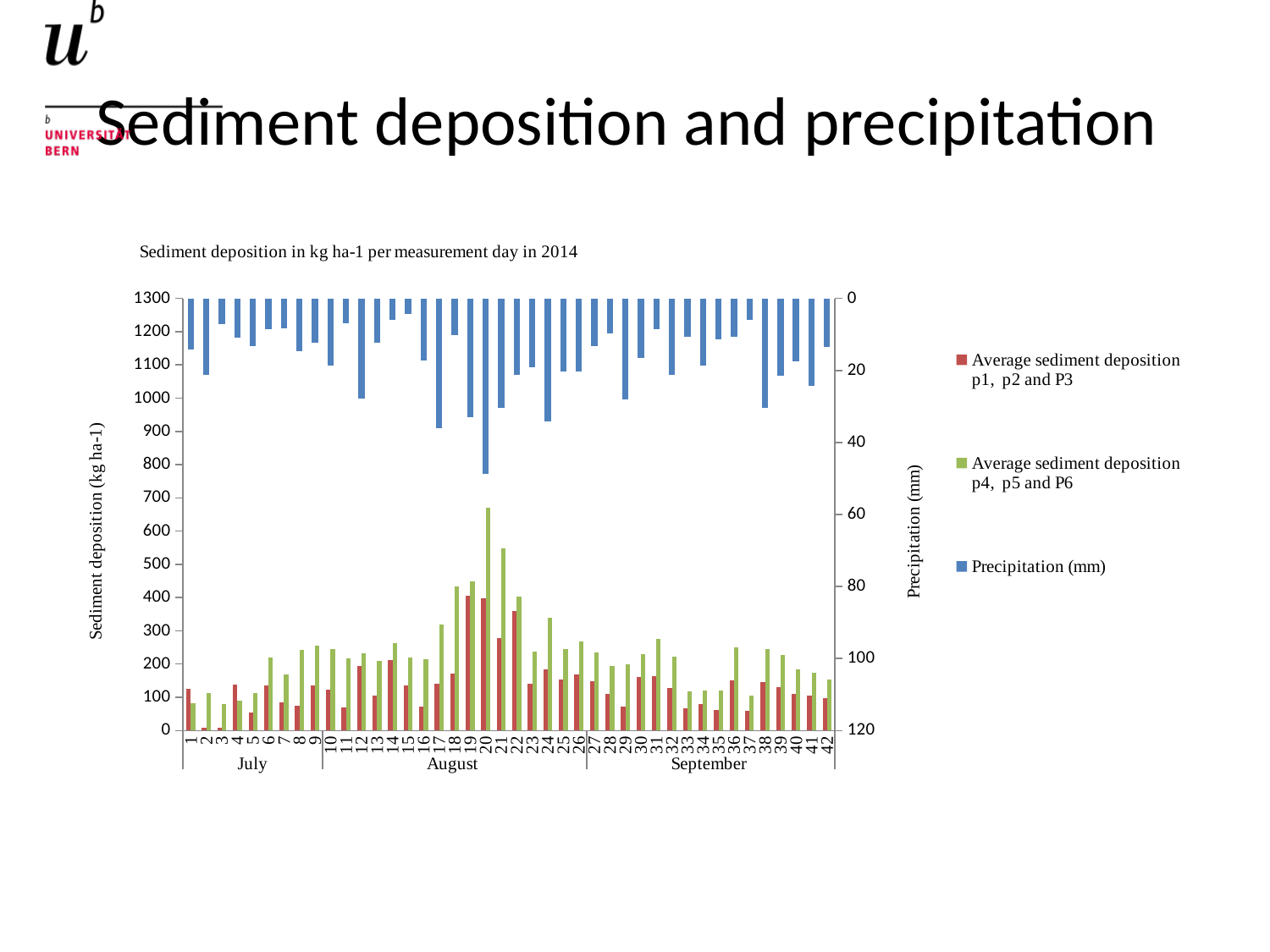
Is the average sediment deposition for p4, p5 and P6 on day 20 greater or less than 600 kg ha-1? greater What is the label of the right-hand vertical axis? Precipitation (mm) What kind of chart is shown on the slide? bar chart Is the average sediment deposition for p4, p5 and P6 on day 21 greater or less than 500 kg ha-1? greater Which measurement day has the highest precipitation? 20 Is the average sediment deposition for p1, p2 and P3 on day 3 greater or less than 100 kg ha-1? less How many series does the legend list? 3 How many measurement days are plotted along the x axis? 42 Which measurement day has the highest average sediment deposition for p4, p5 and P6? 20 Which months are labelled along the x axis of the chart? July, August, September Which is larger, the average sediment deposition for p4, p5 and P6 on day 20 or on day 1? day 20